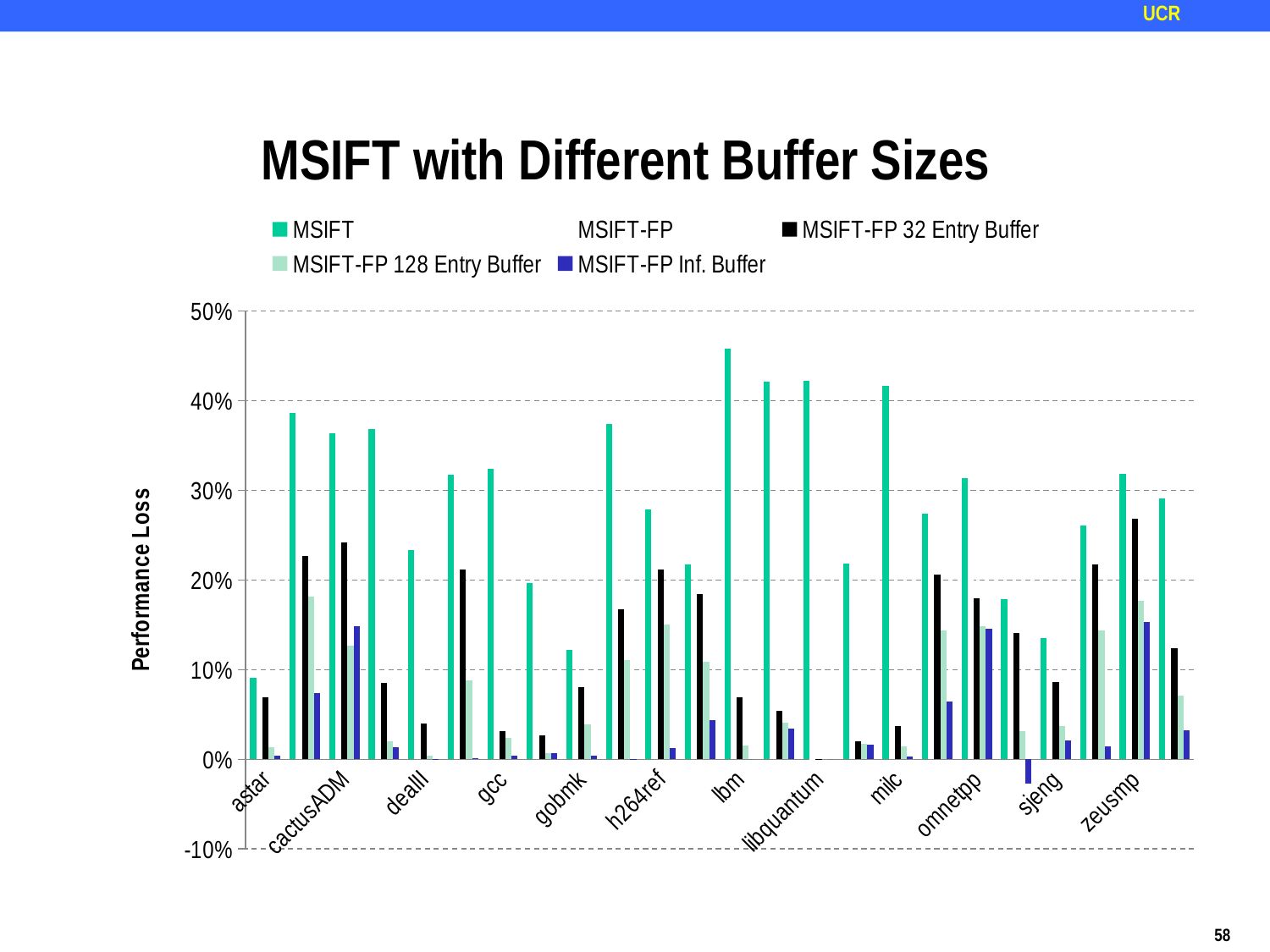
Which category has the highest MSIFT value? lbm Which is larger, the MSIFT-FP 32 Entry Buffer value for cactusADM or for astar? cactusADM Is the MSIFT value for cactusADM greater or less than 30%? greater What is the label on the vertical axis? Performance Loss Which is larger, the MSIFT value for lbm or the MSIFT value for astar? lbm What is the title of the chart? MSIFT with Different Buffer Sizes Is the MSIFT-FP 32 Entry Buffer value for cactusADM greater or less than 20%? greater Is the MSIFT value for dealII greater or less than 20%? greater How many series does the legend list? 5 What kind of chart is shown on the slide? bar chart